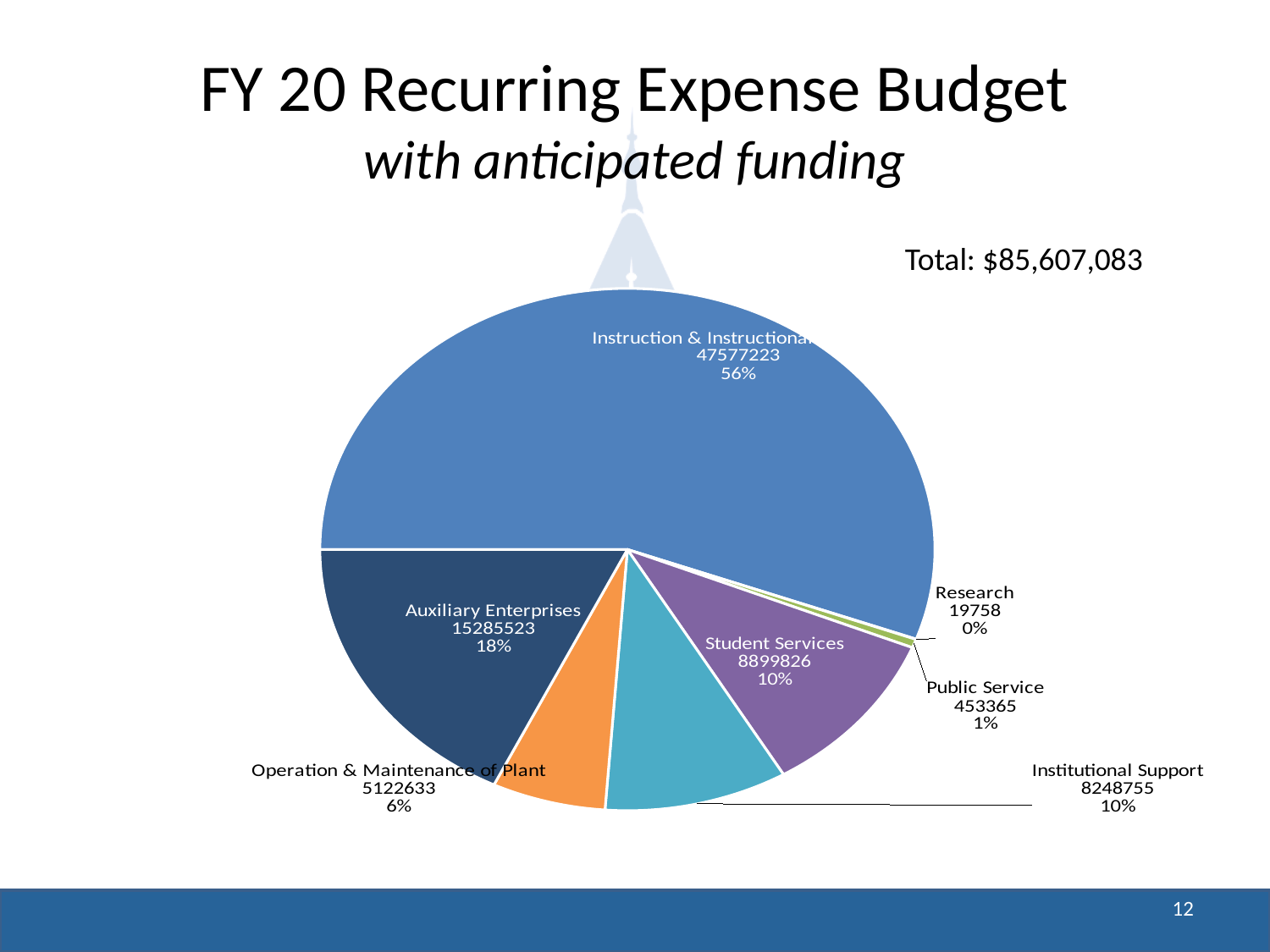
What share of the pie does the largest slice represent? 56% What is the value for Auxiliary Enterprises? 15285523 Which is larger, the value for Student Services or the value for Institutional Support? Student Services What share of the pie does Auxiliary Enterprises represent? 18% How many categories does the pie chart show? 7 Which category has the smallest slice of the pie? Research What is the value for Student Services? 8899826 What total is stated on the slide for the FY 20 Recurring Expense Budget? $85,607,083 What is the difference between the values for Auxiliary Enterprises and Student Services? 6385697 What is the value for Operation & Maintenance of Plant? 5122633 What is the value for Public Service? 453365 What kind of chart is shown on the slide? pie chart